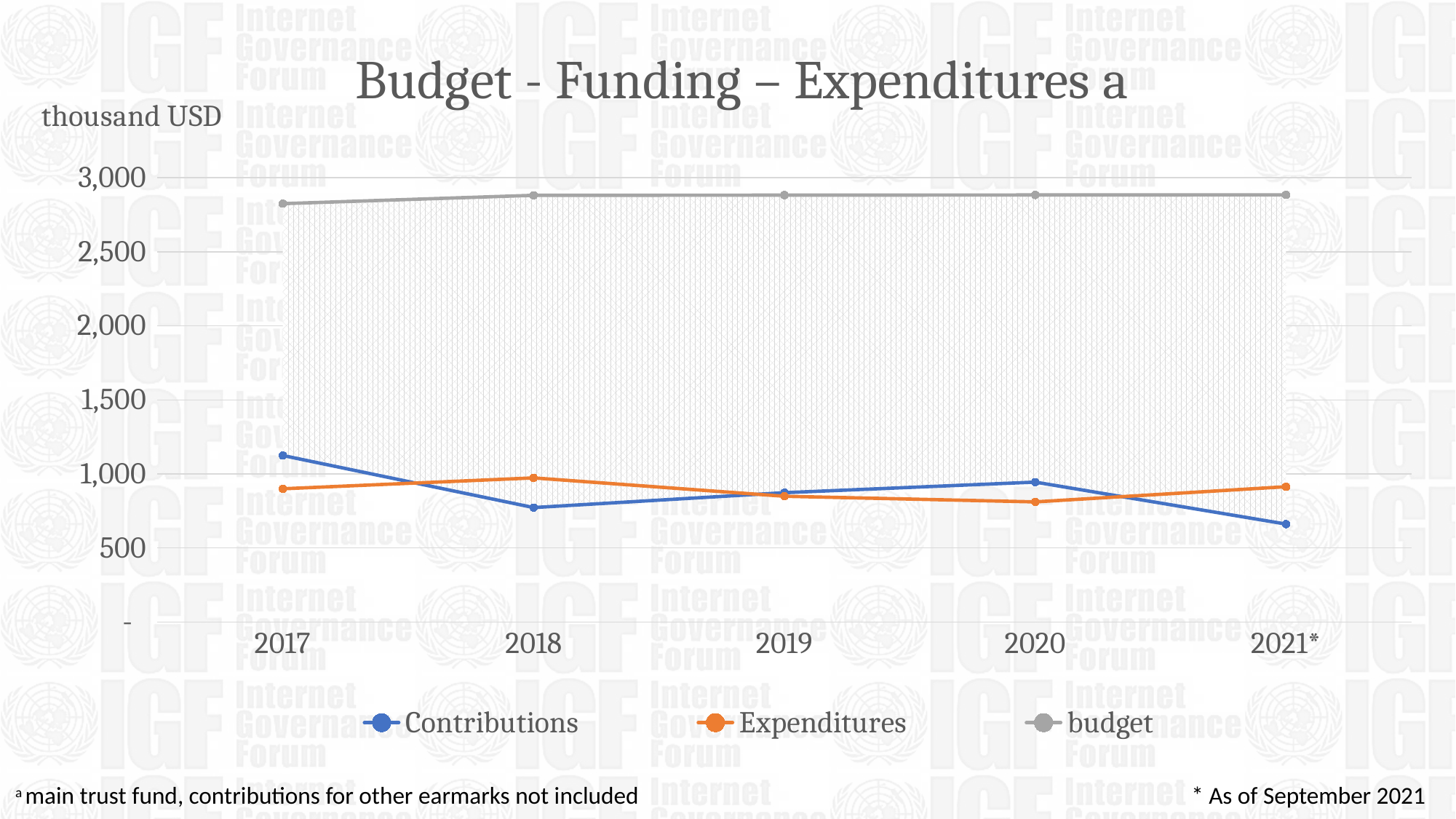
In which year is the Expenditures value highest? 2018 In which year is the Contributions value highest? 2017 How many series does the legend list? 3 What kind of chart is shown on the slide? line chart In which year is the Contributions value lowest? 2021* What unit is given for the y axis? thousand USD Is the Contributions value for 2017 greater or less than 1,000? greater How many years are plotted along the x axis? 5 In 2021*, which is larger, Contributions or Expenditures? Expenditures Is the budget value for 2019 greater or less than 3,000? less In 2017, which is larger, Contributions or Expenditures? Contributions Is the Contributions value for 2018 greater or less than 1,000? less